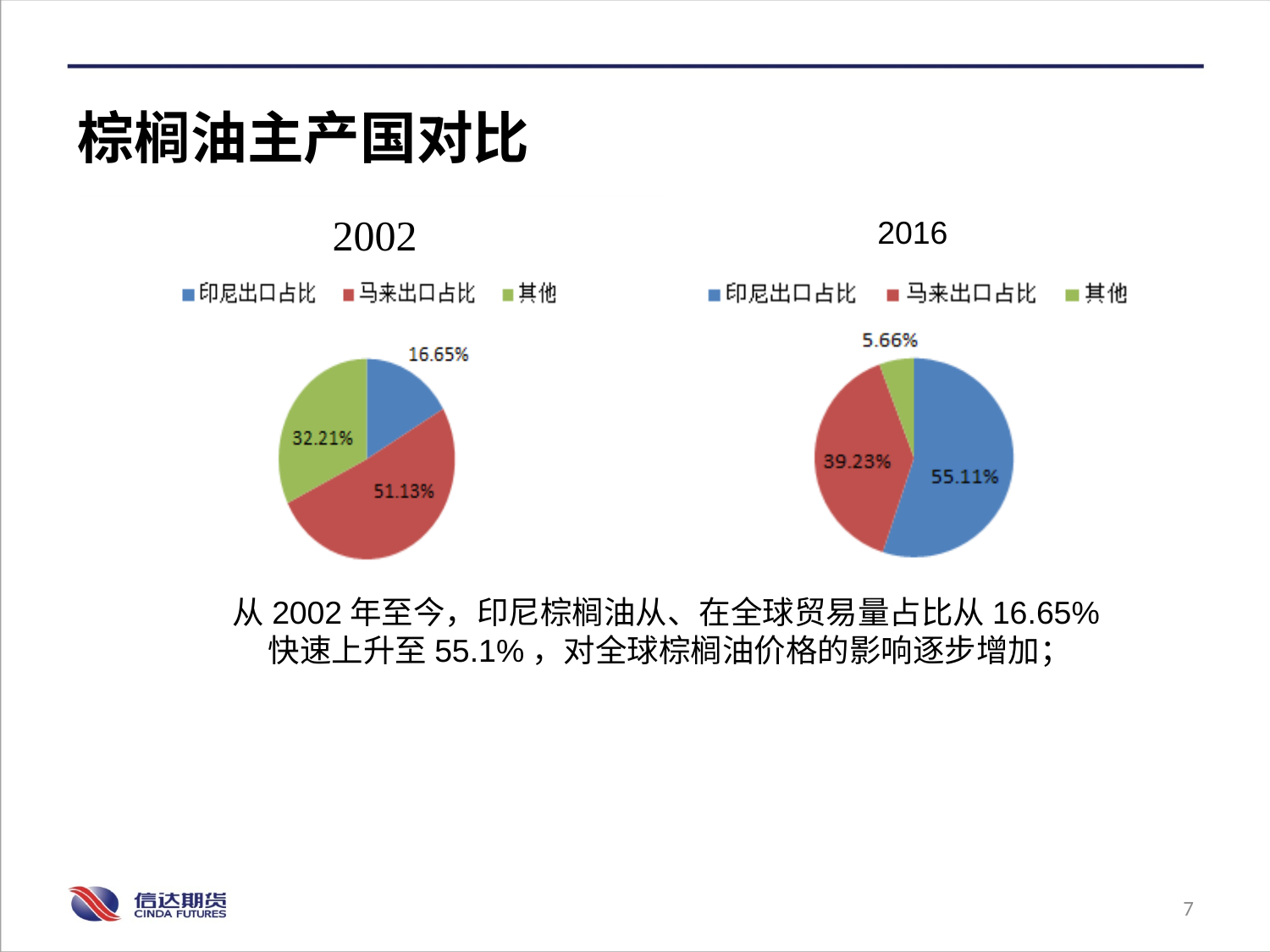
In the 2002 pie chart, what is the share for 马来出口占比? 51.13% In the 2016 pie chart, what is the share for 印尼出口占比? 55.11% What is the difference between the 印尼出口占比 share in the 2016 chart and in the 2002 chart? 38.46% What type of chart is the 2016 chart? Pie chart In the 2016 pie chart, what is the share for 马来出口占比? 39.23% In the 2016 pie chart, which is larger: 印尼出口占比 or 马来出口占比? 印尼出口占比 In the 2016 pie chart, what is the share for 其他? 5.66% In the 2002 pie chart, what is the share for 其他? 32.21% In the 2002 pie chart, which category has the largest share? 马来出口占比 How many series does the legend of the 2002 pie chart list? 3 In the 2016 pie chart, which category has the smallest share? 其他 In the 2002 pie chart, what is the share for 印尼出口占比? 16.65%